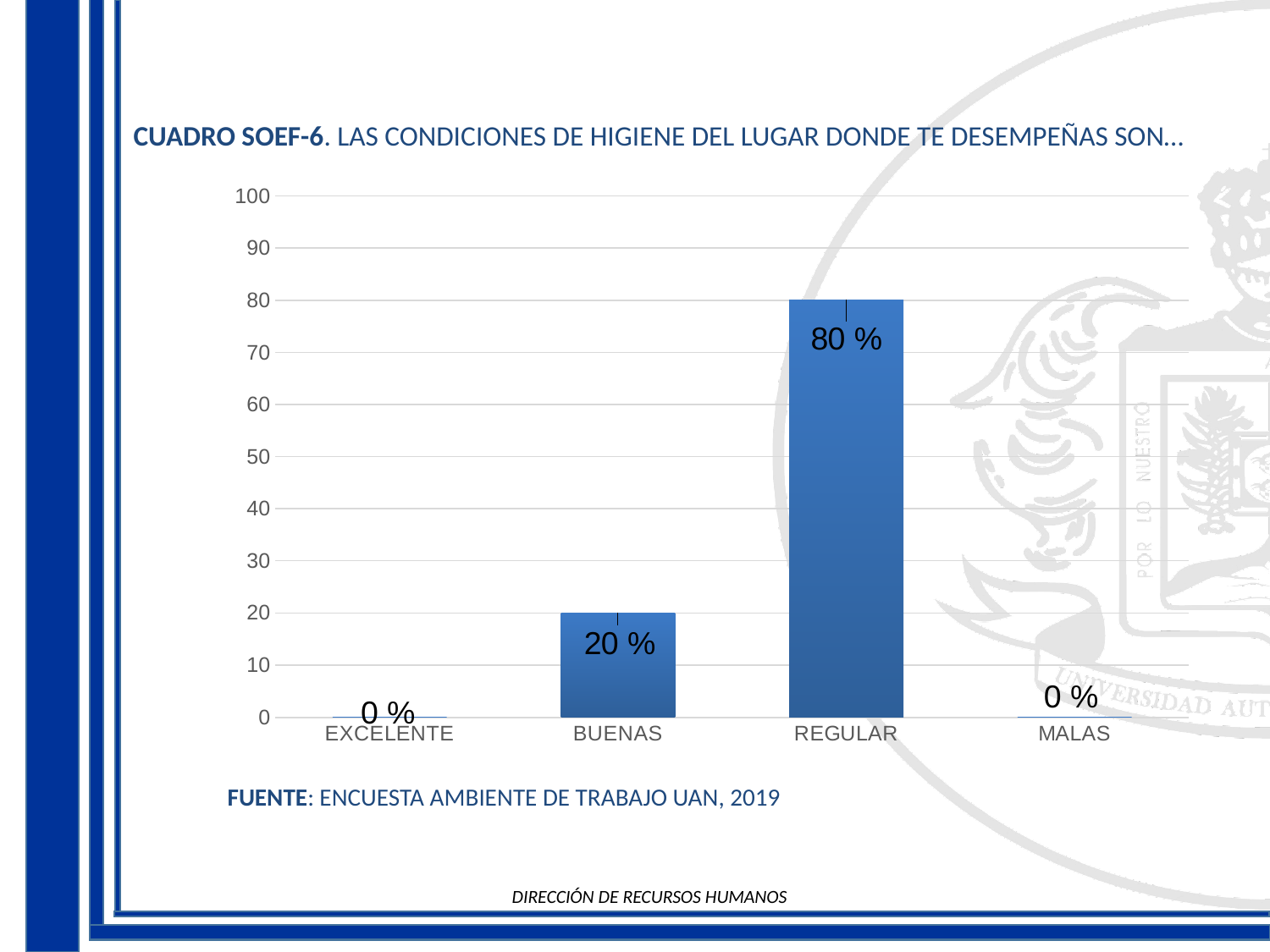
What is the source cited below the chart? ENCUESTA AMBIENTE DE TRABAJO UAN, 2019 What is the value for MALAS? 0 % What is the highest value shown on the y axis? 100 What is the value for EXCELENTE? 0 % Which category has the highest value? REGULAR What kind of chart is shown on the slide? bar chart What is the difference between the values for REGULAR and BUENAS? 60 % Is the value for REGULAR greater or less than 50? greater How many categories are shown on the x axis? 4 What is the value for REGULAR? 80 % What is the value for BUENAS? 20 % Which is larger, the value for BUENAS or the value for REGULAR? REGULAR